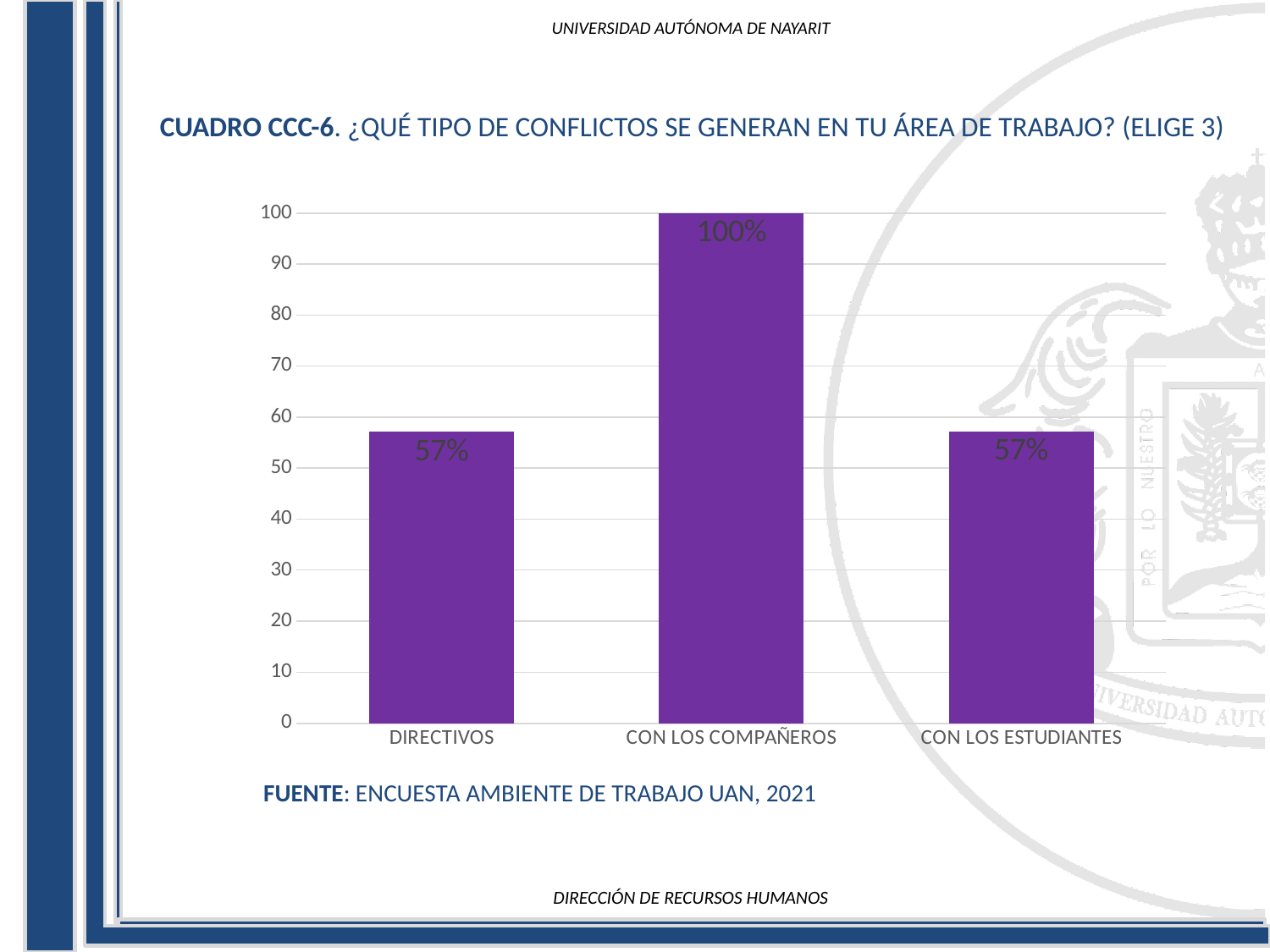
What is the value for CON LOS ESTUDIANTES? 57% What kind of chart is shown on the slide? bar chart How many categories are shown on the x axis? 3 Which is larger, the value for CON LOS COMPAÑEROS or the value for CON LOS ESTUDIANTES? CON LOS COMPAÑEROS What is the value for CON LOS COMPAÑEROS? 100% Which category has the highest value? CON LOS COMPAÑEROS What colour are the bars in the chart? purple What is the difference between the values for CON LOS COMPAÑEROS and DIRECTIVOS? 43% What is the value for DIRECTIVOS? 57% What is the source cited below the chart? ENCUESTA AMBIENTE DE TRABAJO UAN, 2021 Is the value for CON LOS COMPAÑEROS greater or less than 90? greater Is the value for DIRECTIVOS greater or less than 60? less